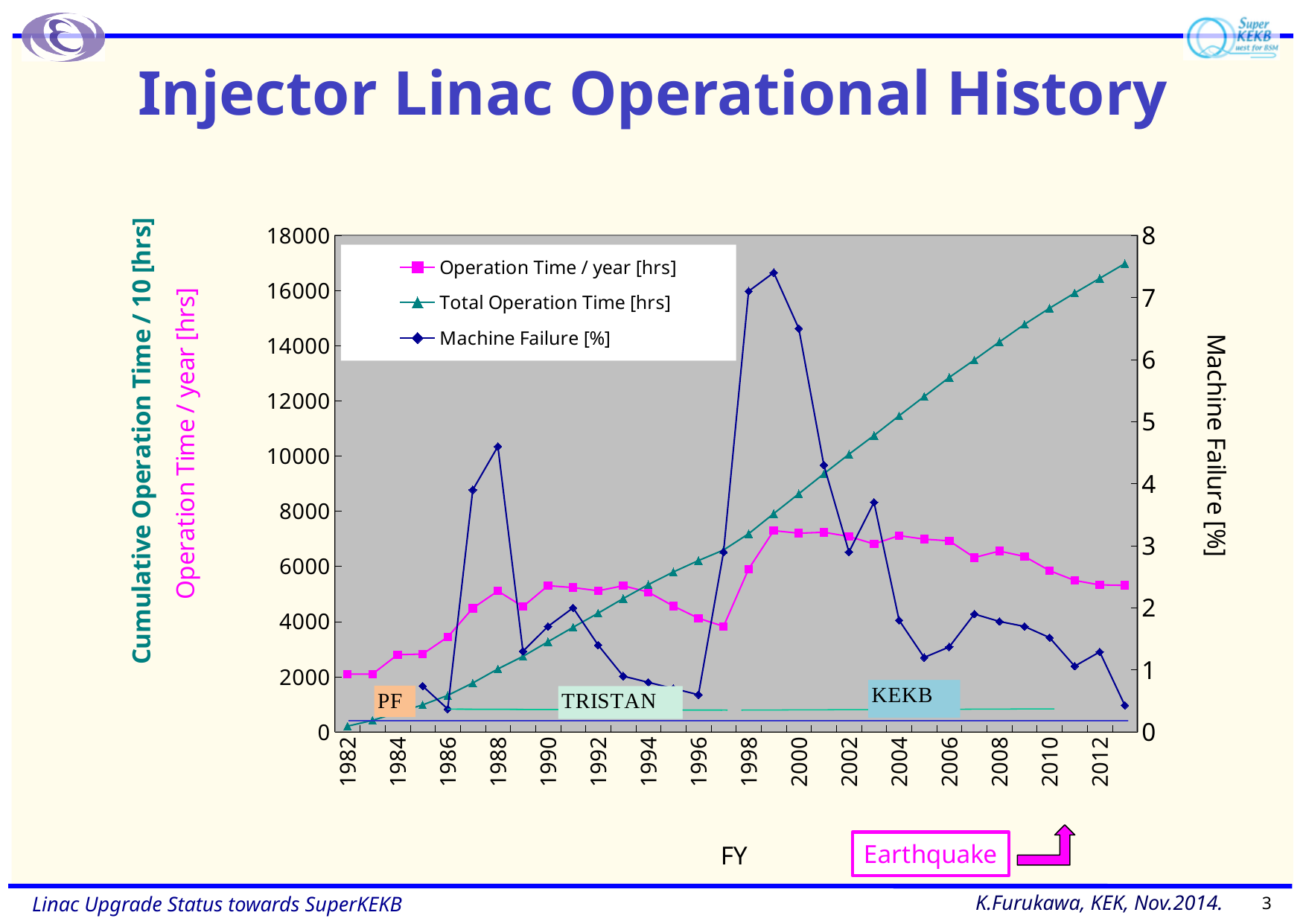
Which is larger, the Operation Time / year [hrs] value in 2013 or in 1982? 2013 Which is larger, the Machine Failure [%] value in 1999 or in 1988? 1999 Which series is plotted with triangle markers according to the legend? Total Operation Time [hrs] What event is annotated with an arrow below the x axis near 2011? Earthquake Is the Operation Time / year [hrs] value for 1982 greater or less than 4000? less In which fiscal year does the Machine Failure [%] series reach its highest value? 1999 What kind of chart is shown on the slide? Line chart Is the Total Operation Time [hrs] value for 2013 greater or less than 16000? greater Does the Total Operation Time [hrs] series rise or fall from 1982 to 2013? Rise How many series does the legend list? 3 Is the Machine Failure [%] value for 1988 greater or less than 4? greater